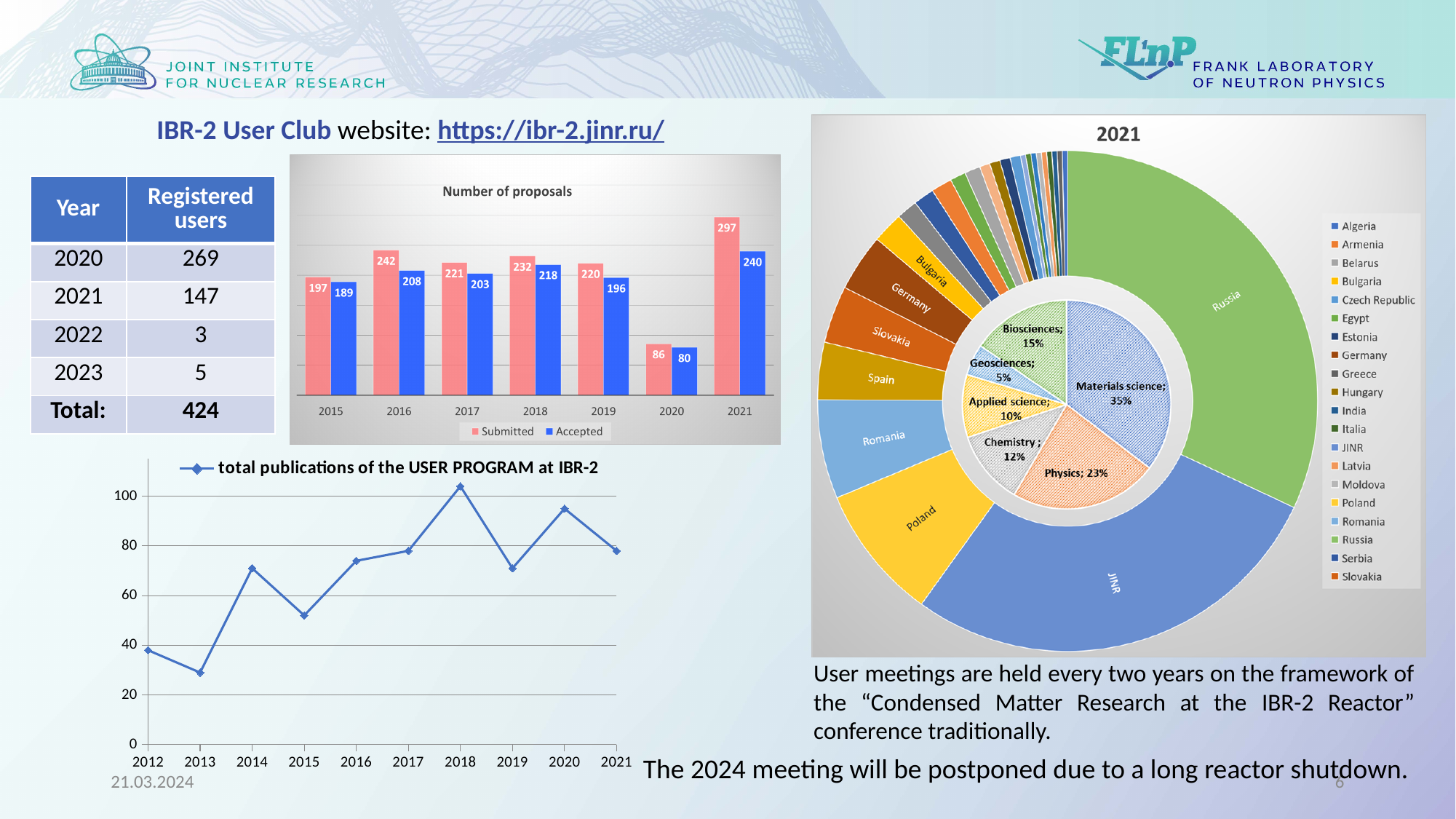
What kind of chart is the 'total publications of the USER PROGRAM at IBR-2' chart? line chart In the 'Number of proposals' chart, which year had the lowest number of submitted proposals? 2020 In the 'total publications of the USER PROGRAM at IBR-2' chart, is the value for 2013 greater or less than 40? less How many series does the legend of the 'Number of proposals' chart list? 2 In the 'total publications of the USER PROGRAM at IBR-2' chart, how many years are shown on the x axis? 10 In the '2021' doughnut chart, what share does Materials science have in the inner ring? 35% In the '2021' doughnut chart, which field has the smallest share in the inner ring? Geosciences In the 'Number of proposals' chart, were more proposals accepted in 2018 or in 2019? 2018 In the 'Number of proposals' chart, what is the difference between submitted and accepted proposals in 2016? 34 In the 'Number of proposals' chart, how many proposals were submitted in 2021? 297 In the 'Number of proposals' chart, how many proposals were accepted in 2017? 203 In the 'total publications of the USER PROGRAM at IBR-2' chart, which year has the highest value? 2018